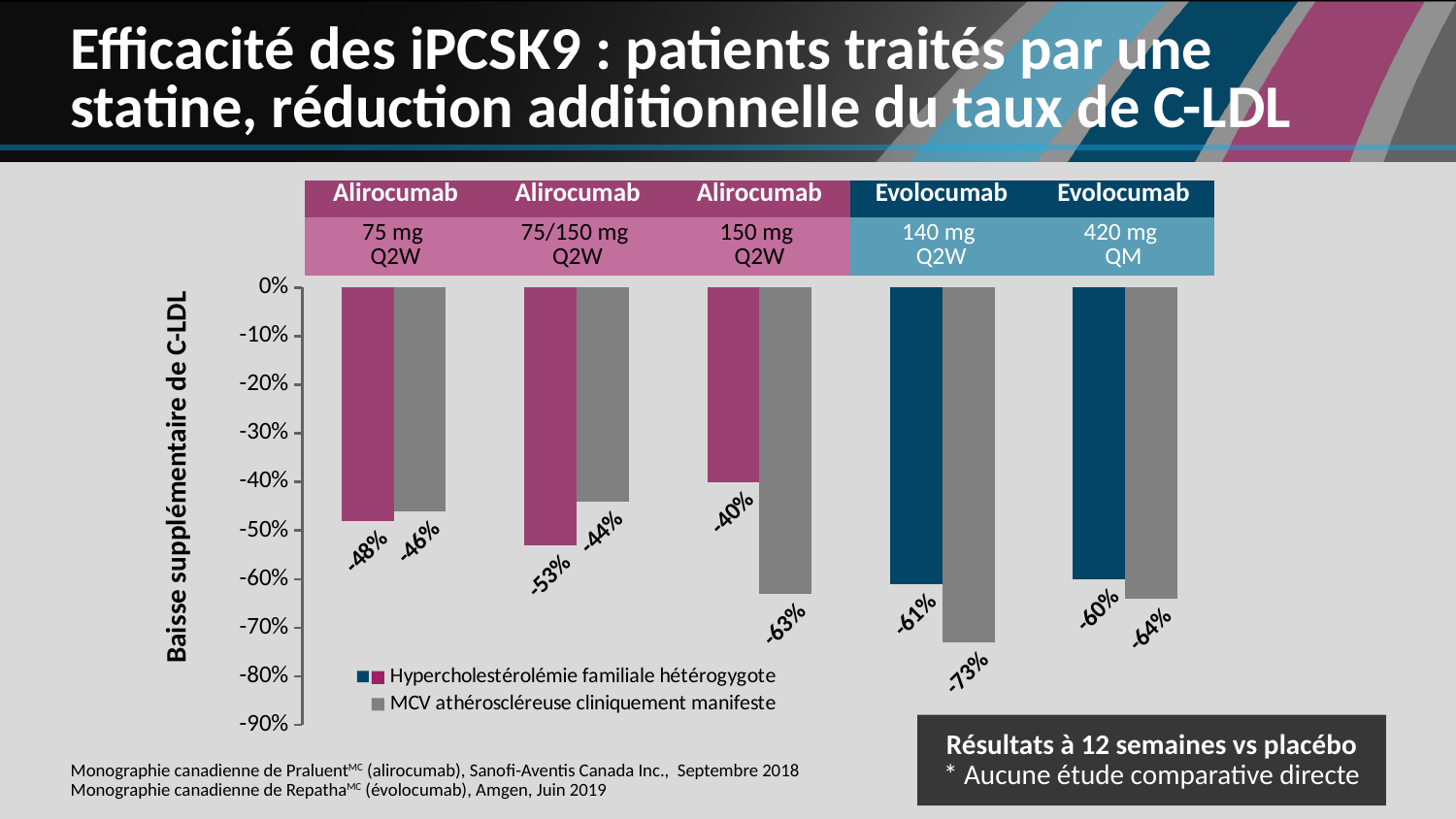
What is the difference between the two series values for Alirocumab 150 mg Q2W (-40% and -63%)? 23 percentage points How many series does the legend list? 2 What is the label of the y axis? Baisse supplémentaire de C-LDL Which treatment group shows the smallest LDL-C reduction in the Hypercholestérolémie familiale hétérozygote series? Alirocumab 150 mg Q2W What is the value for Alirocumab 150 mg Q2W in the Hypercholestérolémie familiale hétérozygote series? -40% How many treatment groups (dose regimens) are shown on the x axis? 5 For Alirocumab 75/150 mg Q2W, which series shows the larger reduction: Hypercholestérolémie familiale hétérozygote or MCV athéroscléreuse cliniquement manifeste? Hypercholestérolémie familiale hétérozygote What kind of chart is shown on the slide? Bar chart What is the value for Evolocumab 420 mg QM in the MCV athéroscléreuse cliniquement manifeste series? -64% Which treatment group shows the largest LDL-C reduction in the MCV athéroscléreuse cliniquement manifeste series? Evolocumab 140 mg Q2W What is the value for Evolocumab 140 mg Q2W in the MCV athéroscléreuse cliniquement manifeste series? -73% What is the value for Alirocumab 75 mg Q2W in the Hypercholestérolémie familiale hétérozygote series? -48%